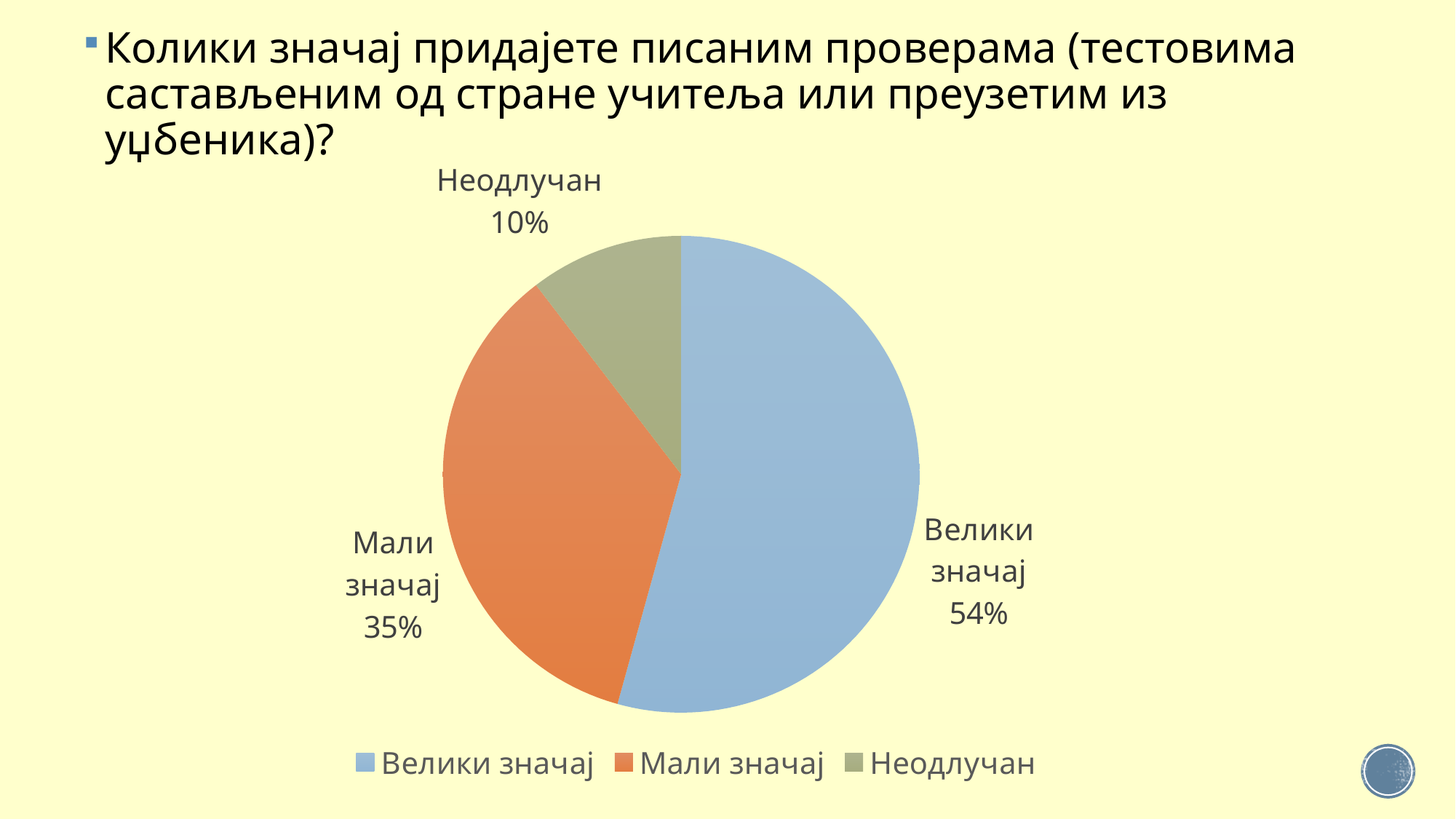
Which category has the smallest share of the pie? Неодлучан How many categories does the pie chart have? 3 What percentage is shown for Велики значај? 54% What percentage is shown for Мали значај? 35% How many entries does the legend list? 3 What percentage is shown for Неодлучан? 10% Which category has the largest share of the pie? Велики значај What is the difference in percentage points between Мали значај and Неодлучан? 25 What kind of chart is shown on the slide? pie chart What colour is the slice for Мали значај? orange Which is larger, the share for Мали значај or the share for Неодлучан? Мали значај What is the difference in percentage points between Велики значај and Мали значај? 19